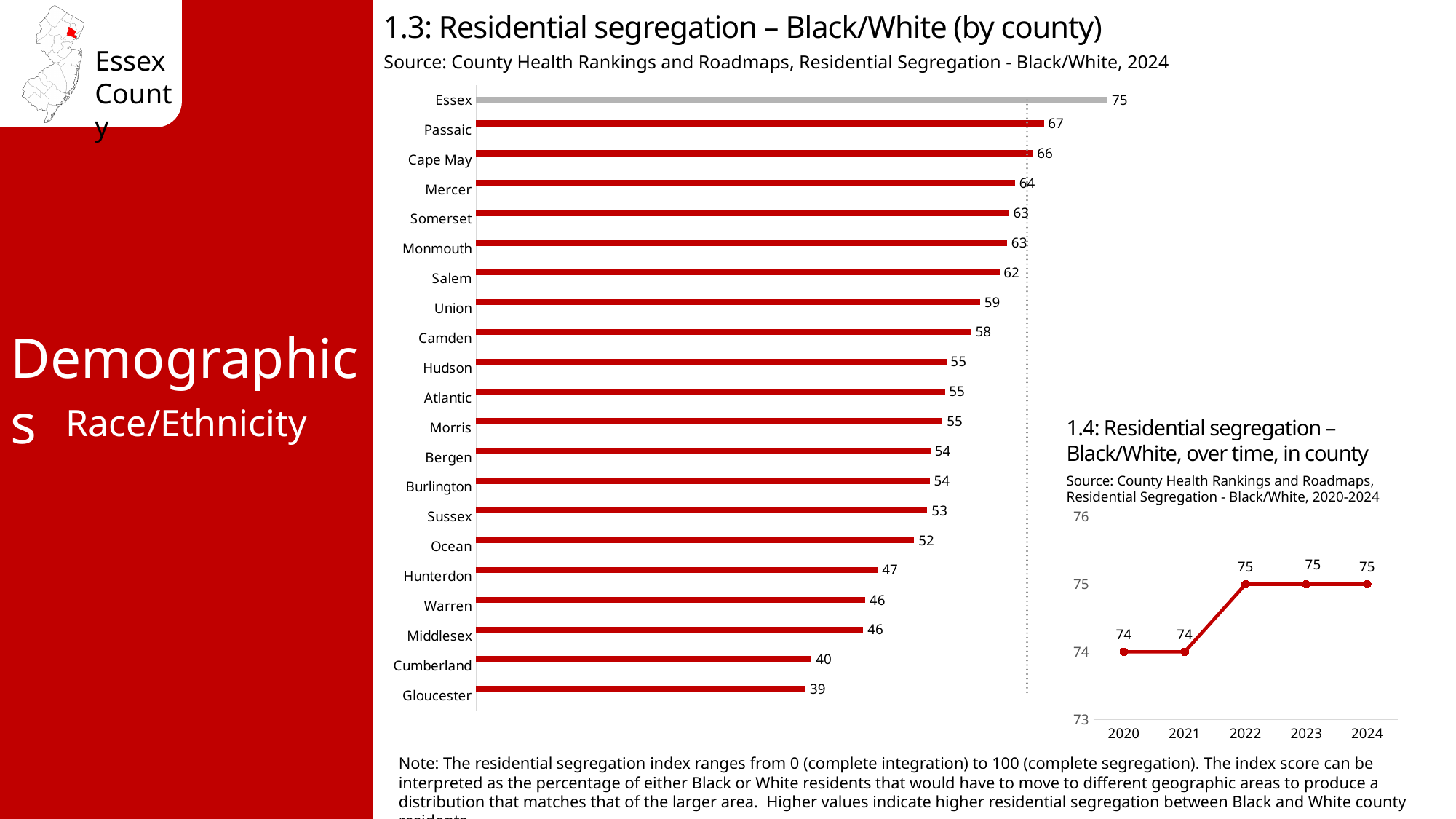
In chart 1.3 (by county), how many counties are shown? 21 In chart 1.3 (by county), which has a larger value, Salem or Ocean? Salem In chart 1.4 (over time), do the values rise or fall from 2020 to 2024? Rise In chart 1.3 (by county), what is the value for Gloucester? 39 In chart 1.3 (by county), which county has the lowest value? Gloucester In chart 1.4 (over time), how many years are plotted? 5 In chart 1.3 (Residential segregation – Black/White by county), what is the value for Passaic? 67 What kind of chart is chart 1.3 (Residential segregation – Black/White by county)? Bar chart In chart 1.3 (by county), which county has the highest value? Essex In chart 1.3 (by county), what is the difference between the values for Essex and Cumberland? 35 In chart 1.4 (Residential segregation over time), what is the value for 2021? 74 What kind of chart is chart 1.4 (Residential segregation over time)? Line chart